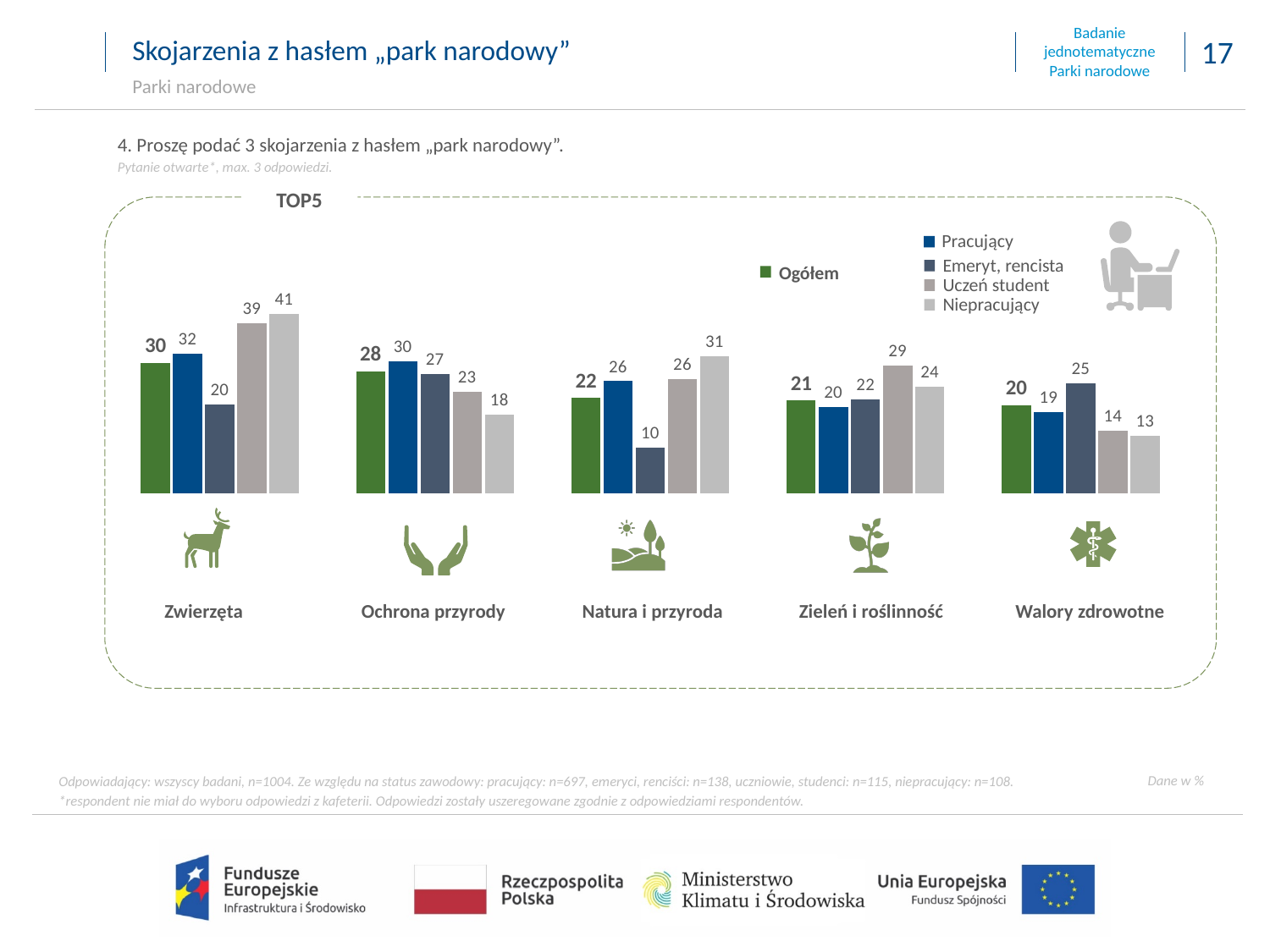
How many categories are shown in the chart? 5 What is the Niepracujący value for Natura i przyroda? 31 What is the Uczeń student value for Zieleń i roślinność? 29 Which category has the lowest Niepracujący value? Walory zdrowotne How many bars are plotted for each category? 5 What is the Emeryt, rencista value for Natura i przyroda? 10 What type of chart is shown on the slide? Bar chart What is the difference between the Niepracujący and Ogółem values for Zwierzęta? 11 Which is larger for Ochrona przyrody: the Pracujący value or the Niepracujący value? Pracujący Do the Ogółem values rise or fall from Zwierzęta to Walory zdrowotne? Fall What is the Ogółem value for Zwierzęta? 30 Which category has the highest Ogółem value? Zwierzęta